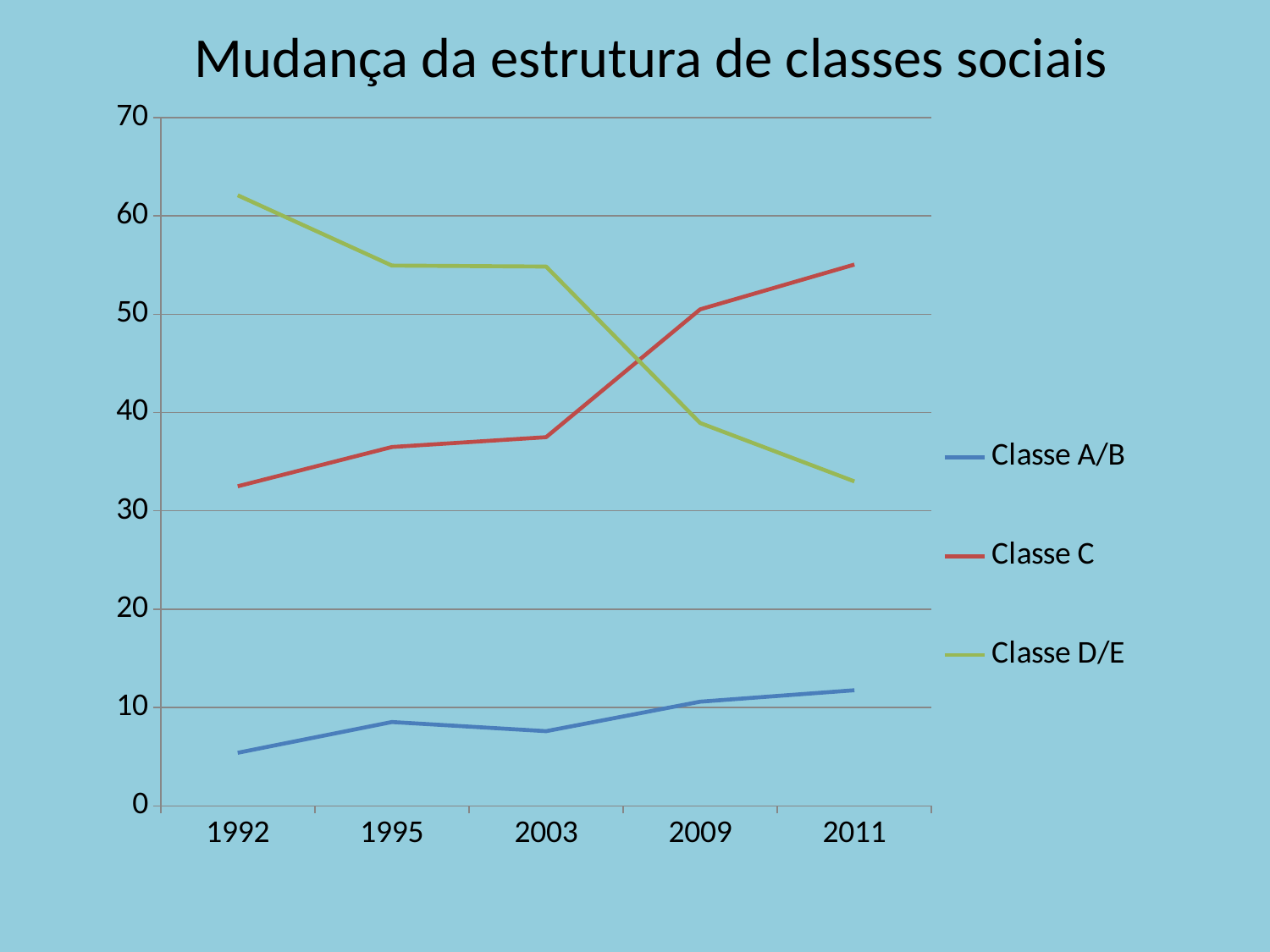
In which year is Classe C at its lowest? 1992 Is the value for Classe D/E in 2011 greater or less than 30? greater How many years are plotted along the x axis? 5 Is the value for Classe C in 2011 greater or less than 50? greater In which year is Classe D/E at its highest? 1992 What is the title of the chart? Mudança da estrutura de classes sociais In 2011, which is larger: Classe C or Classe D/E? Classe C Does the Classe D/E line rise or fall from 1992 to 2011? fall Is the value for Classe A/B in 1992 greater or less than 10? less What kind of chart is shown on the slide? line chart How many series does the legend list? 3